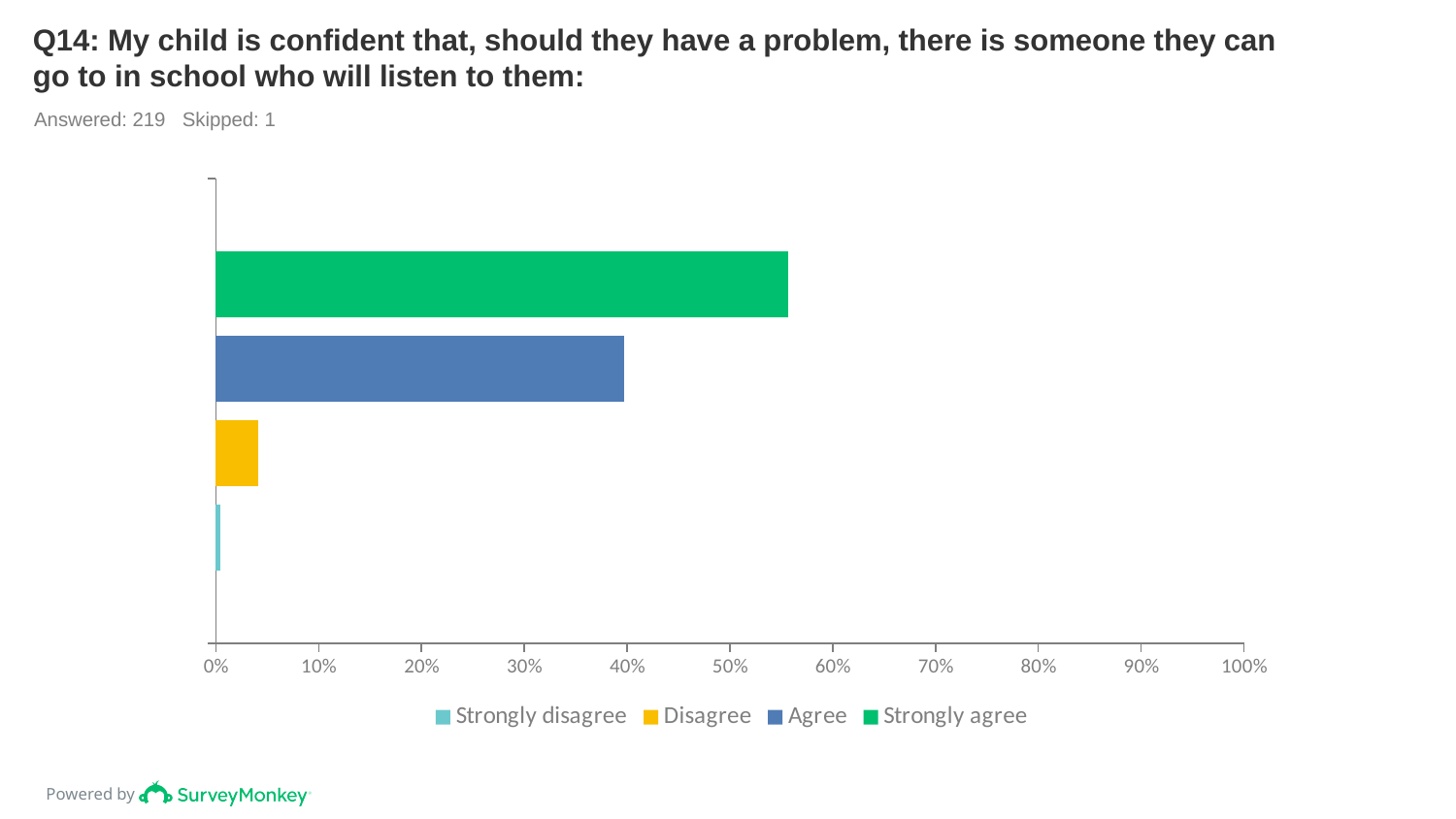
How many responses were answered according to the slide? 219 Is the value for Strongly agree greater or less than 50%? greater Is the value for Agree greater or less than 30%? greater Is the value for Strongly disagree greater or less than 10%? less Which response option has the highest value? Strongly agree How many series does the legend list? 4 What kind of chart is shown on the slide? bar chart Which response option has the lowest value? Strongly disagree Which is larger, the value for Agree or the value for Disagree? Agree What colour is the bar for Strongly agree? green Which is larger, the value for Strongly agree or the value for Agree? Strongly agree